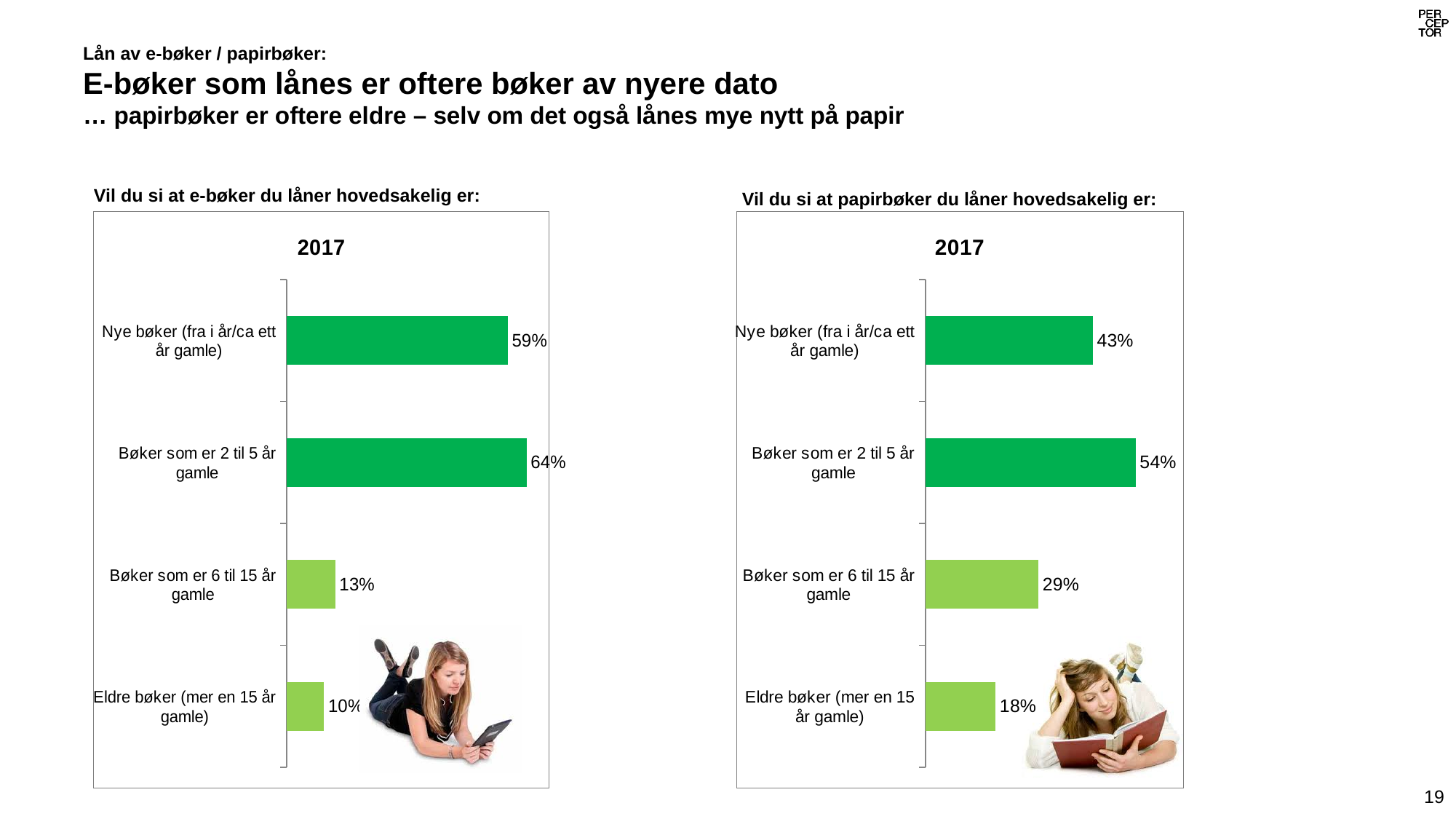
In the left chart (e-bøker), what is the difference between 'Nye bøker' and 'Bøker som er 6 til 15 år gamle'? 46% In the right chart (papirbøker), what is the value for 'Bøker som er 6 til 15 år gamle'? 29% In the right chart (papirbøker), which category has the lowest value? Eldre bøker (mer en 15 år gamle) What kind of chart is the left chart (e-bøker)? Bar chart In the left chart (e-bøker), which category has the highest value? Bøker som er 2 til 5 år gamle In the left chart (e-bøker), what is the value for 'Eldre bøker (mer en 15 år gamle)'? 10% In the left chart (e-bøker), what is the value for 'Bøker som er 2 til 5 år gamle'? 64% In the right chart (papirbøker), what is the value for 'Nye bøker (fra i år/ca ett år gamle)'? 43% How many categories are shown in the right chart (papirbøker)? 4 In the right chart (papirbøker), what is the difference between 'Bøker som er 2 til 5 år gamle' and 'Eldre bøker (mer en 15 år gamle)'? 36% Which is larger: the value for 'Nye bøker' in the left chart (e-bøker) or in the right chart (papirbøker)? Left chart (e-bøker), 59% What year is shown as the title inside both charts? 2017